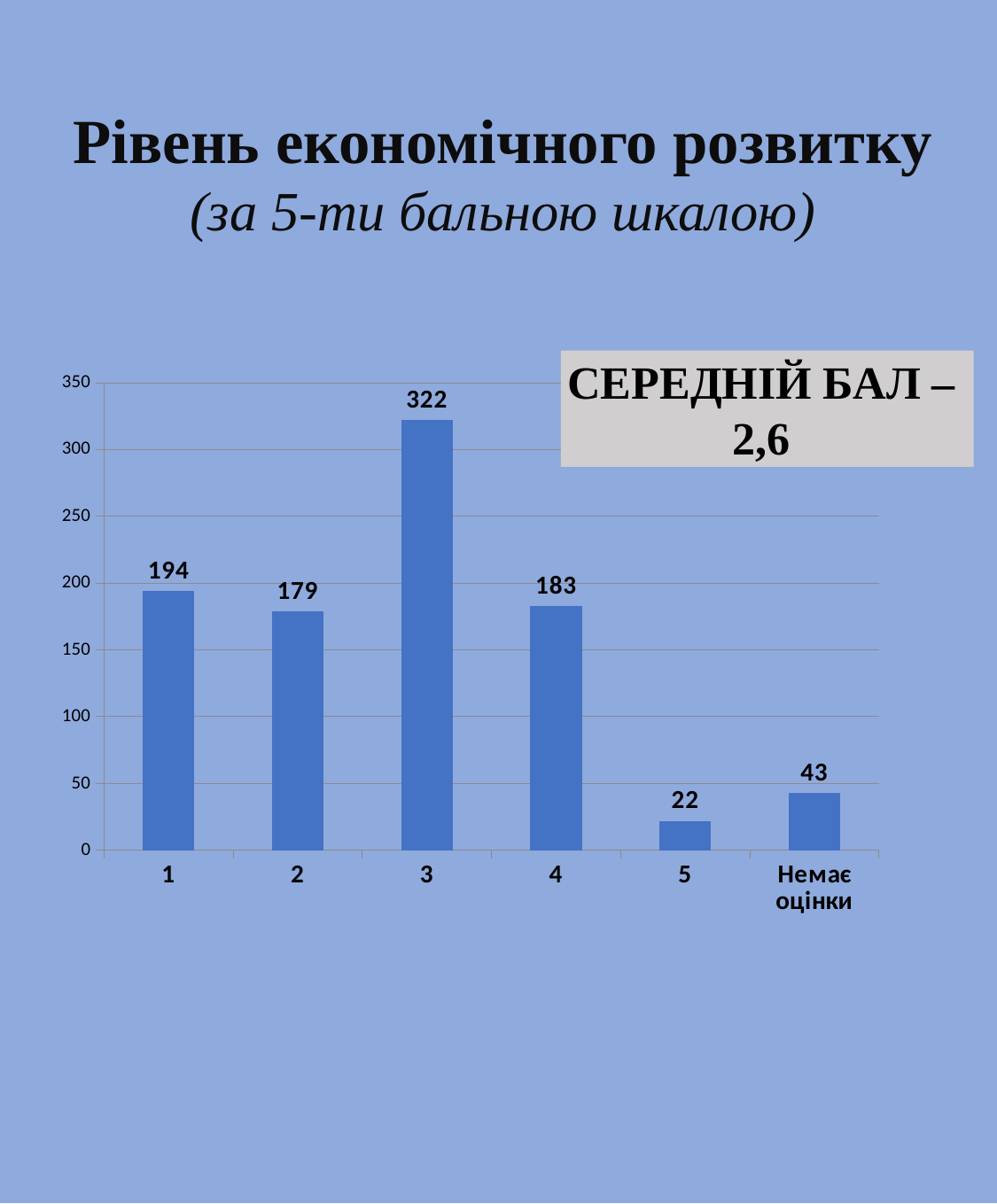
What is the value for category 1? 194 Which is larger, the value for category 2 or the value for category 4? 4 Is the value for category 3 greater or less than 300? greater Which category has the highest value? 3 Which category has the lowest value? 5 How many categories are shown on the x axis? 6 What kind of chart is shown on the slide? bar chart What is the value for the 'Немає оцінки' category? 43 What is the difference between the values for category 3 and category 4? 139 What average score (середній бал) is stated in the box on the slide? 2,6 What is the value for category 3? 322 What is the difference between the values for category 1 and category 2? 15